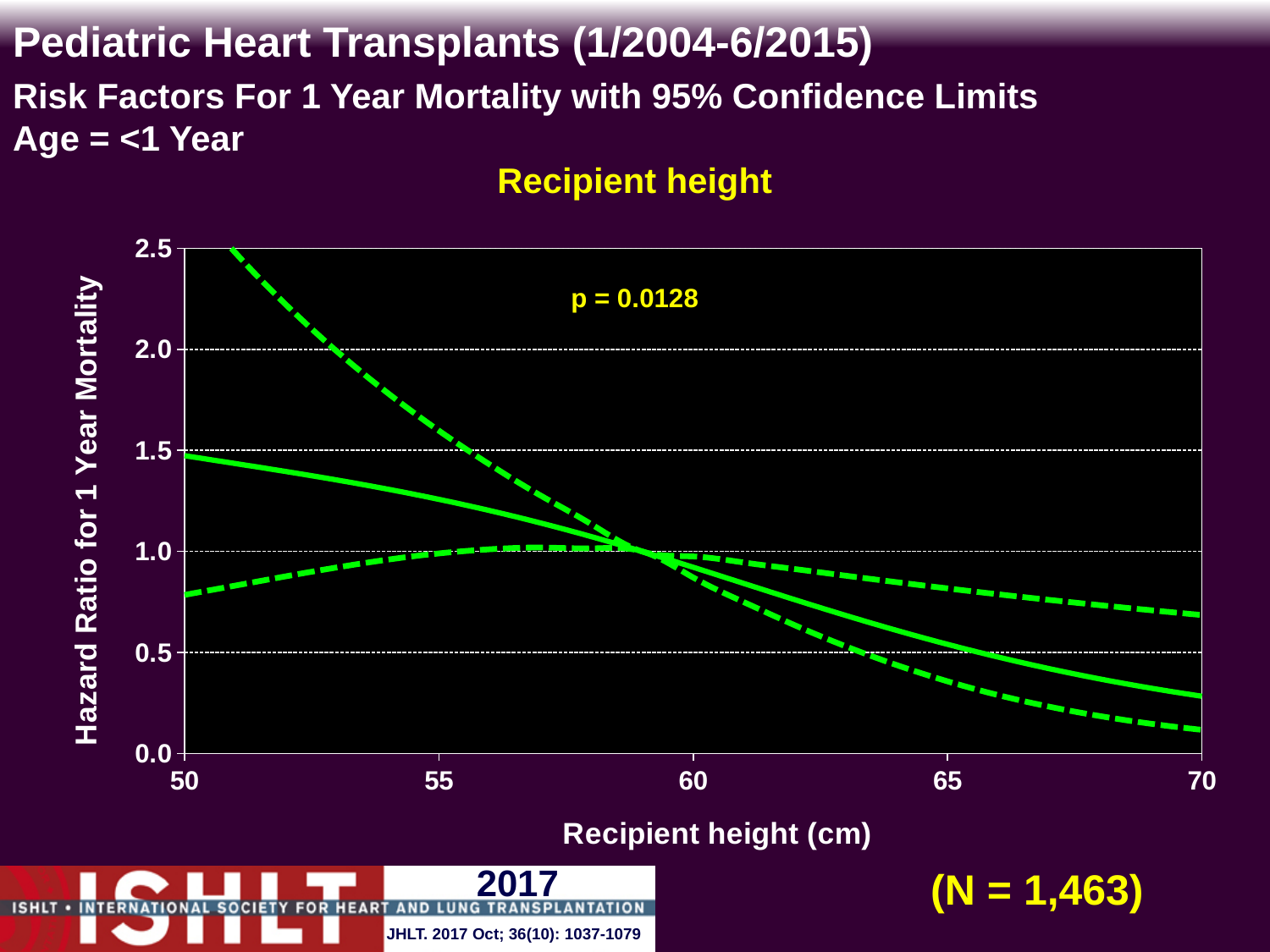
Is the lower confidence limit (lower dashed line) at a recipient height of 50 cm greater or less than 1.0? less How many lines are plotted on the chart? 3 Is the hazard ratio (solid line) at a recipient height of 70 cm greater or less than 0.5? less Is the upper confidence limit (upper dashed line) at a recipient height of 50 cm greater or less than 2.0? greater What p-value is printed on the chart? p = 0.0128 Does the solid hazard ratio line rise or fall as recipient height increases from 50 cm to 70 cm? fall What is the label of the x axis? Recipient height (cm) What is the label of the y axis? Hazard Ratio for 1 Year Mortality What kind of chart is shown on the slide? line chart